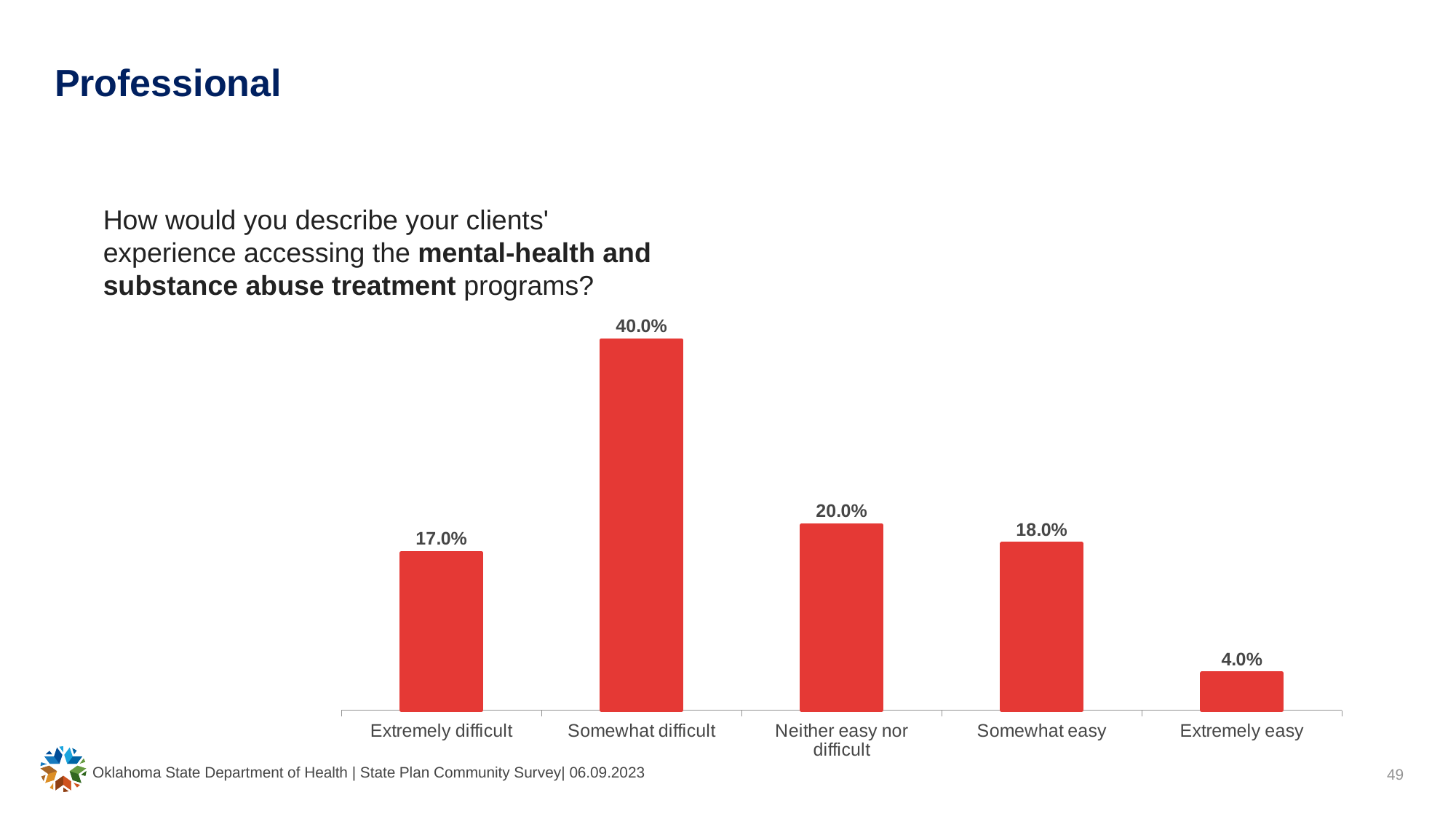
How many categories are shown on the x axis of the chart? 5 What is the value shown for 'Extremely easy'? 4.0% What is the difference between the values for 'Somewhat easy' and 'Extremely difficult'? 1.0% Which category has the highest value? Somewhat difficult What colour are the bars in the chart? Red Which category has the lowest value? Extremely easy What is the combined value of 'Extremely difficult' and 'Somewhat difficult'? 57.0% What is the difference between the values for 'Somewhat difficult' and 'Neither easy nor difficult'? 20.0% What kind of chart is shown on the slide? Bar chart Which is larger, the value for 'Extremely difficult' or the value for 'Extremely easy'? Extremely difficult What percentage of respondents said their clients' experience accessing mental-health and substance abuse treatment programs was 'Somewhat difficult'? 40.0% What is the value shown for 'Neither easy nor difficult'? 20.0%